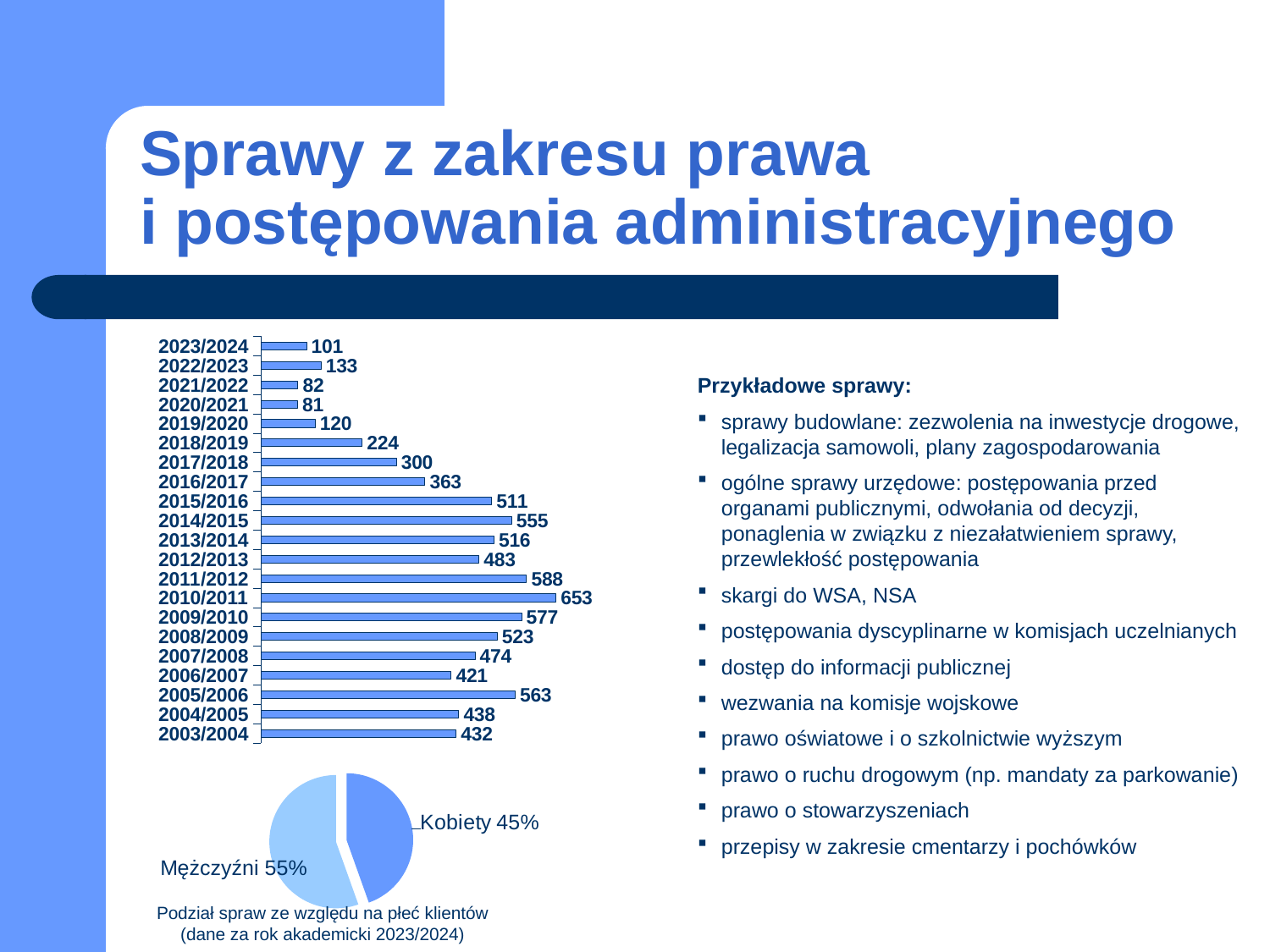
What kind of chart is the chart showing values by academic year? bar chart In the bar chart, what is the value for 2010/2011? 653 What is the caption below the pie chart? Podział spraw ze względu na płeć klientów (dane za rok akademicki 2023/2024) In the bar chart, what is the value for 2023/2024? 101 In the bar chart, what is the value for 2017/2018? 300 In the bar chart, which academic year has the highest value? 2010/2011 In the bar chart, which is larger: the value for 2005/2006 or the value for 2004/2005? 2005/2006 In the bar chart, which academic year has the lowest value? 2020/2021 In the bar chart, what is the difference between the values for 2022/2023 and 2021/2022? 51 In the pie chart, which slice is larger: Kobiety or Mężczyźni? Mężczyźni In the pie chart, what share is labelled Kobiety? 45% How many academic years are shown in the bar chart? 21